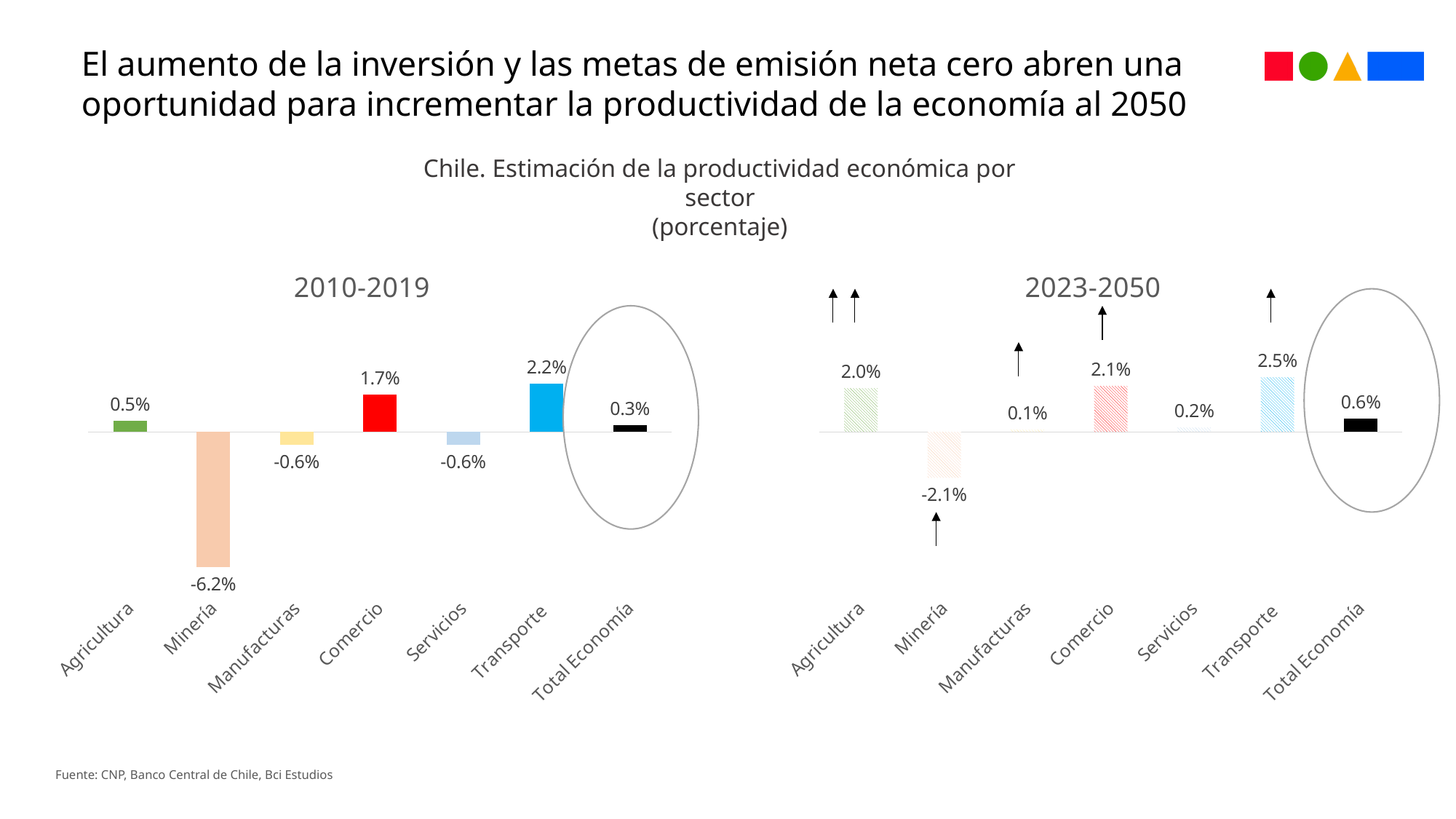
In the 2023-2050 chart, which sector has the lowest value? Minería How many sectors (categories) are shown in the 2010-2019 chart? 7 In the 2010-2019 chart, what is the value for Minería? -6.2% What is the title shown above the two charts? Chile. Estimación de la productividad económica por sector (porcentaje) In the 2023-2050 chart, what is the difference between the values for Total Economía and Manufacturas? 0.5% In the 2023-2050 chart, which is larger, the value for Agricultura or the value for Comercio? Comercio In the 2023-2050 chart, what is the value for Transporte? 2.5% What kind of chart is the 2023-2050 chart? Bar chart In the 2010-2019 chart, what is the value for Total Economía? 0.3% In the 2010-2019 chart, which sector has the highest value? Transporte In the 2010-2019 chart, what is the difference between the values for Transporte and Comercio? 0.5% In the 2023-2050 chart, what is the value for Total Economía? 0.6%